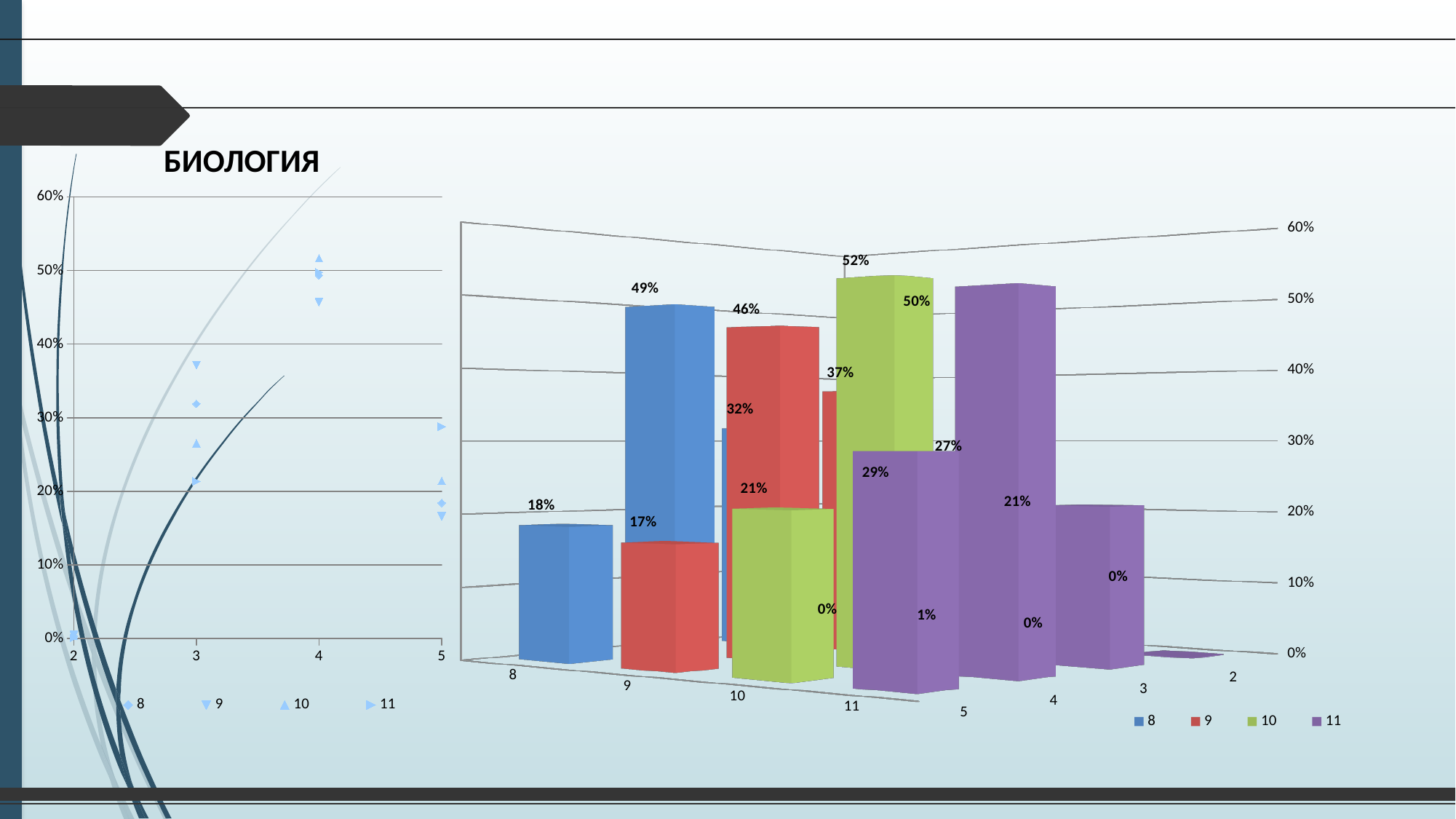
In the bar chart on the right, what value is labelled on the front blue bar (series 8, category 5)? 18% In the bar chart on the right, which is larger: the tall blue bar labelled 49% or the tall red bar labelled 46%? the blue bar (49%) What kind of chart is the chart on the right of the slide? bar chart In the bar chart on the right, what is the highest value printed as a data label? 52% How many categories are shown along the depth axis of the bar chart on the right? 4 What are the legend entries of the bar chart on the right? 8, 9, 10, 11 What kind of chart is the chart on the left of the slide? scatter chart In the bar chart on the right, what value is labelled on the front green bar (series 10, category 5)? 21% In the bar chart on the right, what value is labelled on the front red bar (series 9, category 5)? 17% How many series does the legend of the scatter chart on the left list? 4 In the bar chart on the right, what value is labelled on the tall blue bar in the second row (series 8, category 4)? 49% How many series does the legend of the bar chart on the right list? 4